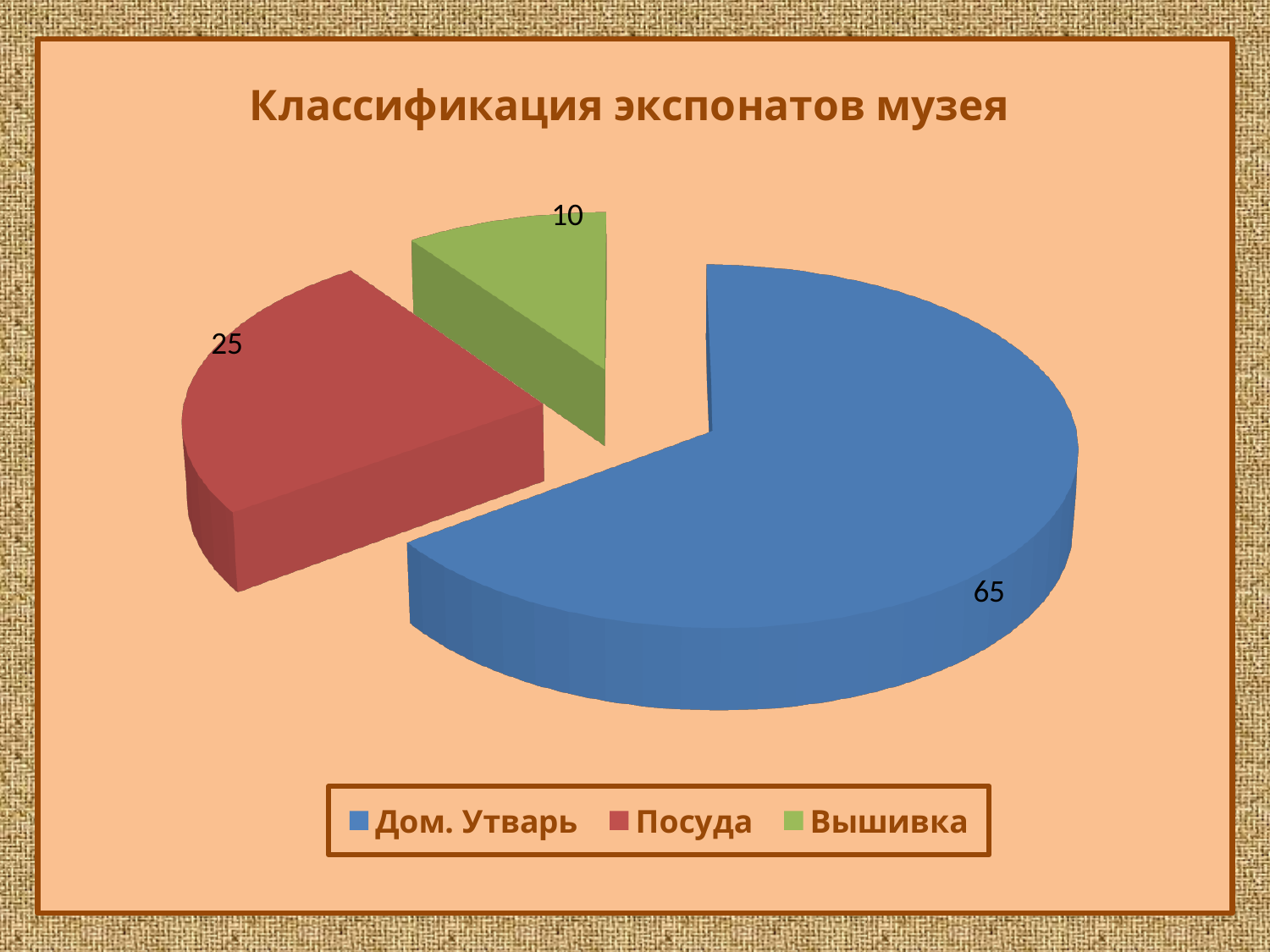
What is the title of the chart? Классификация экспонатов музея How many categories does the pie chart have? 3 What is the difference between the values for Дом. Утварь and Посуда? 40 Which is larger, the value for Посуда or the value for Вышивка? Посуда What is the value for Вышивка? 10 What type of chart is shown on the slide? Pie chart What colour is the slice for Посуда? Red What is the difference between the values for Посуда and Вышивка? 15 Which category has the largest slice? Дом. Утварь What is the value for Посуда? 25 What is the value for Дом. Утварь? 65 Which category has the smallest slice? Вышивка